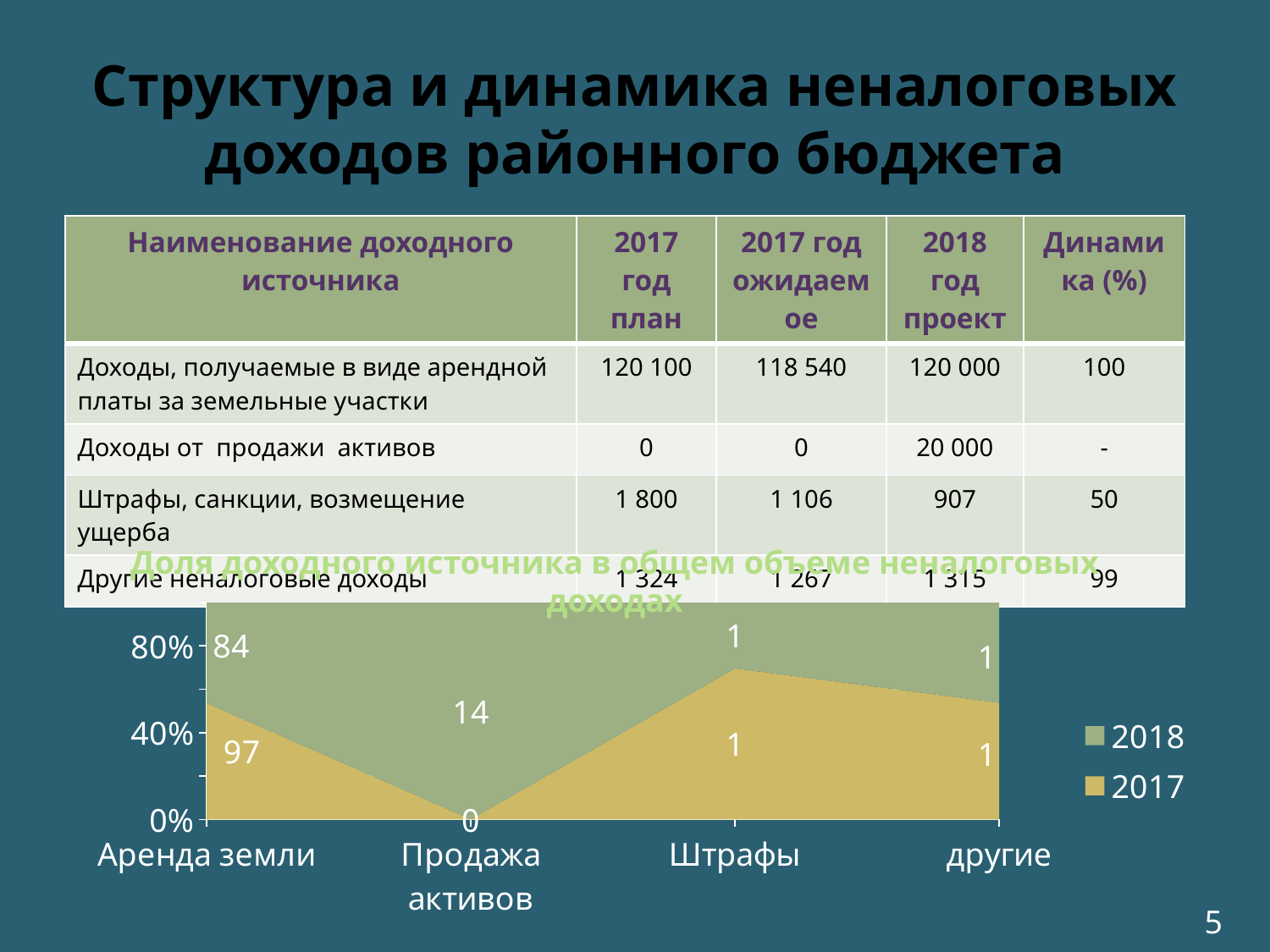
What kind of chart is shown on the slide? area chart In the chart, what is the 2018 value for Аренда земли? 84 How many categories are shown on the x axis of the chart? 4 How many series does the chart legend list? 2 In the chart, what is the 2018 value for Продажа активов? 14 What is the difference between the 2017 and 2018 values for Аренда земли? 13 For Аренда земли, which is larger: the 2017 value or the 2018 value? 2017 Do the 2018 values rise or fall from Аренда земли to другие? fall In the chart, what is the 2017 value for Продажа активов? 0 Which category has the lowest 2017 value in the chart? Продажа активов Which category has the highest 2017 value in the chart? Аренда земли In the chart, what is the 2017 value for Аренда земли? 97